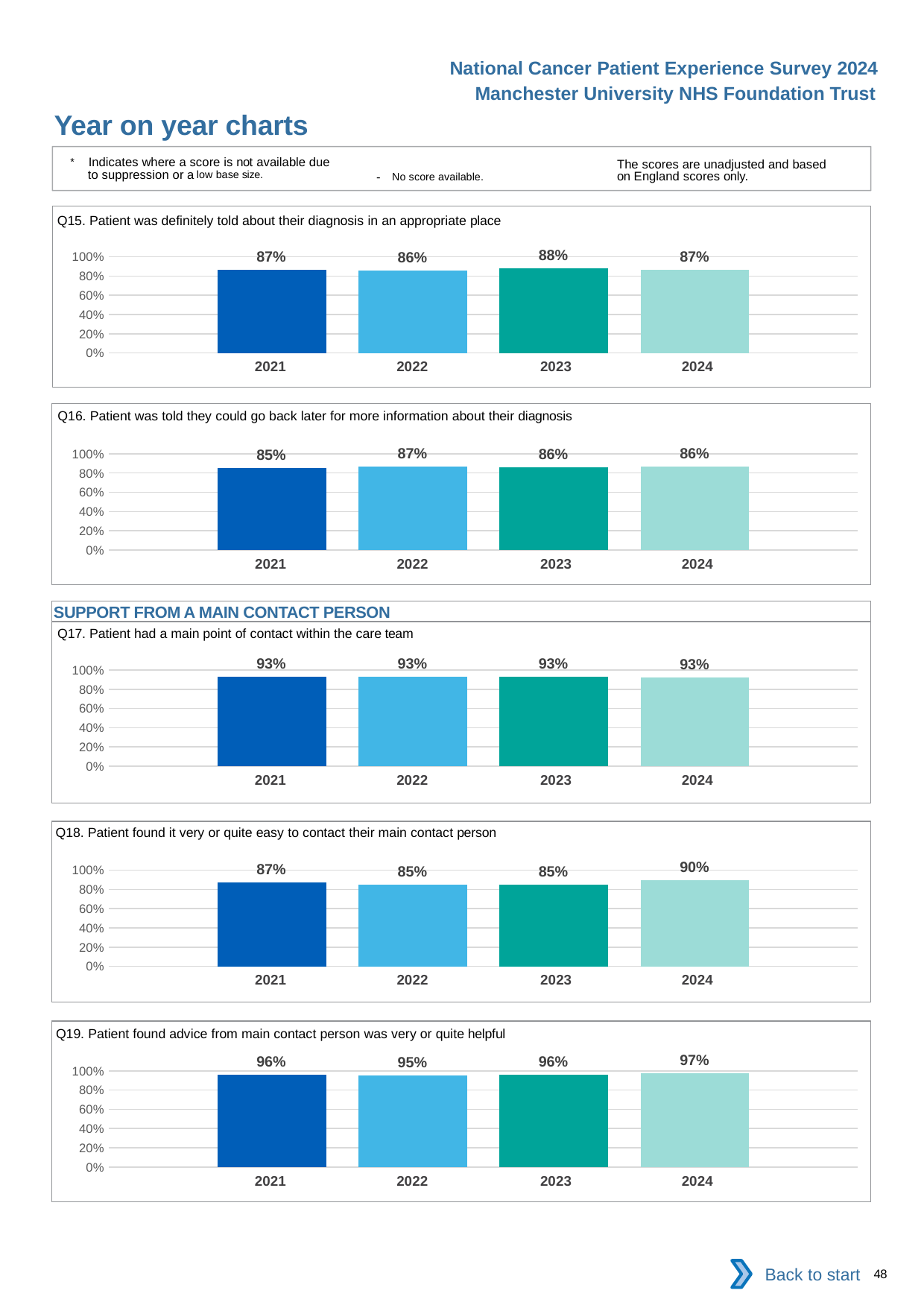
In the Q18 chart, which year has the highest value? 2024 In the Q19 chart (patient found advice from main contact person was very or quite helpful), what is the value for 2022? 95% In the Q15 chart, which year has the lowest value? 2022 In the Q19 chart, is the value for 2023 greater or less than 80%? greater How many bars are plotted in the Q17 chart? 4 In the Q17 chart (patient had a main point of contact within the care team), what is the value for 2024? 93% In the Q15 chart (patient was definitely told about their diagnosis in an appropriate place), what is the value for 2023? 88% In the Q18 chart (patient found it very or quite easy to contact their main contact person), what is the difference between the 2024 and 2023 values? 5 percentage points In the Q16 chart (patient was told they could go back later for more information), what is the value for 2021? 85% In the Q19 chart, is the value for 2021 or 2024 larger? 2024 In the Q16 chart, which year has the highest value? 2022 What type of chart is used for Q15? Bar chart